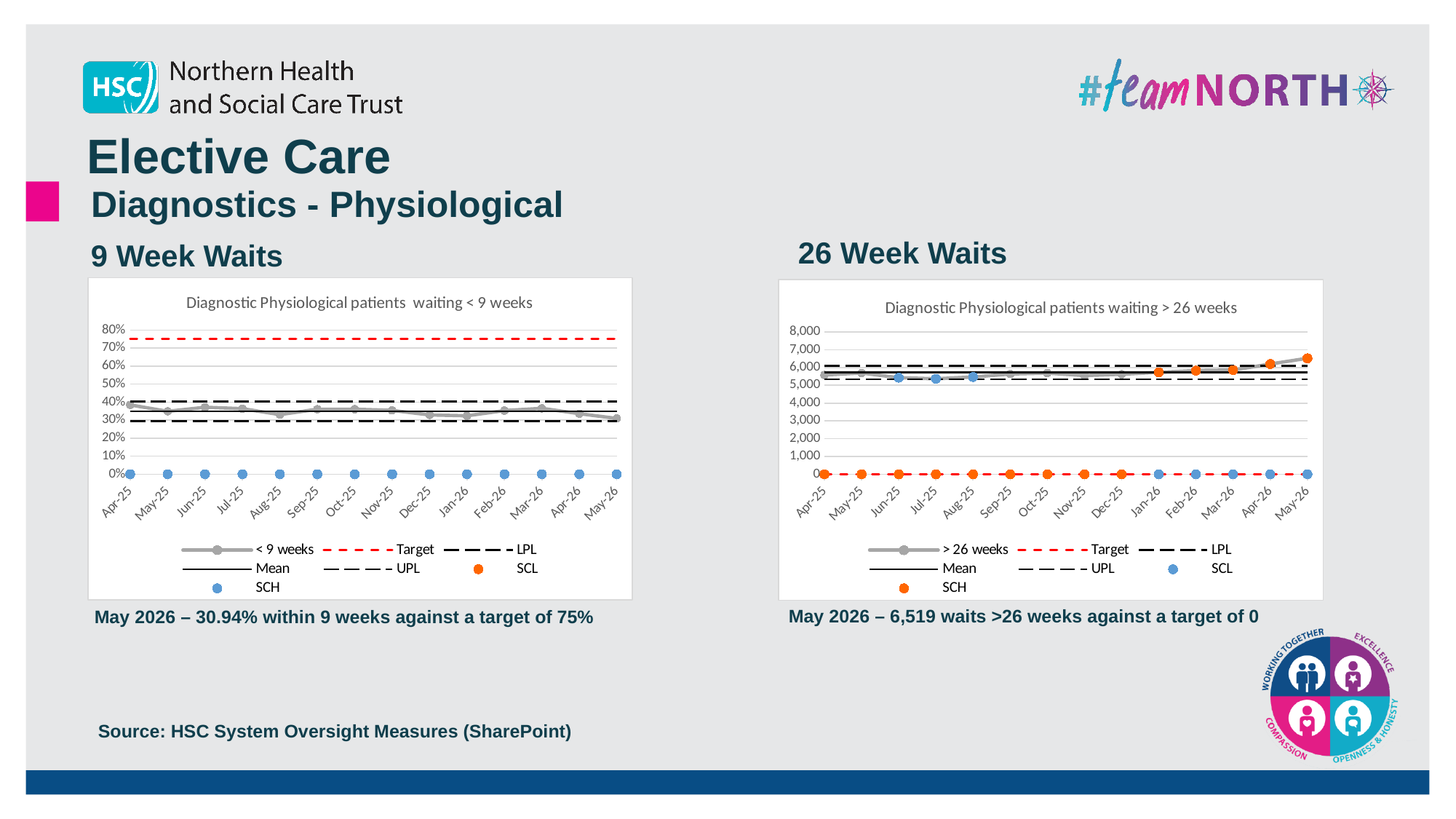
In the '9 Week Waits' chart, what is the target value for patients waiting < 9 weeks? 75% How many series does the legend of the '9 Week Waits' chart list? 7 According to the slide, what was the percentage of Diagnostic Physiological patients waiting < 9 weeks in May 2026? 30.94% In the '26 Week Waits' chart, what is the target value for waits > 26 weeks? 0 What type of chart is the '9 Week Waits' chart (Diagnostic Physiological patients waiting < 9 weeks)? Line chart In the '9 Week Waits' chart, is the value for Apr-25 greater or less than 50%? less In the '26 Week Waits' chart, do the waits > 26 weeks generally rise or fall from Apr-25 to May-26? Rise In the '9 Week Waits' chart, which is larger: the value for Apr-25 or the value for May-26? Apr-25 In the '26 Week Waits' chart, which month has the highest number of waits > 26 weeks? May-26 In the '26 Week Waits' chart, is the value for May-26 greater or less than 6,000? greater According to the slide, how many Diagnostic Physiological waits > 26 weeks were there in May 2026? 6,519 In the '26 Week Waits' chart, how many months are plotted along the x axis? 14